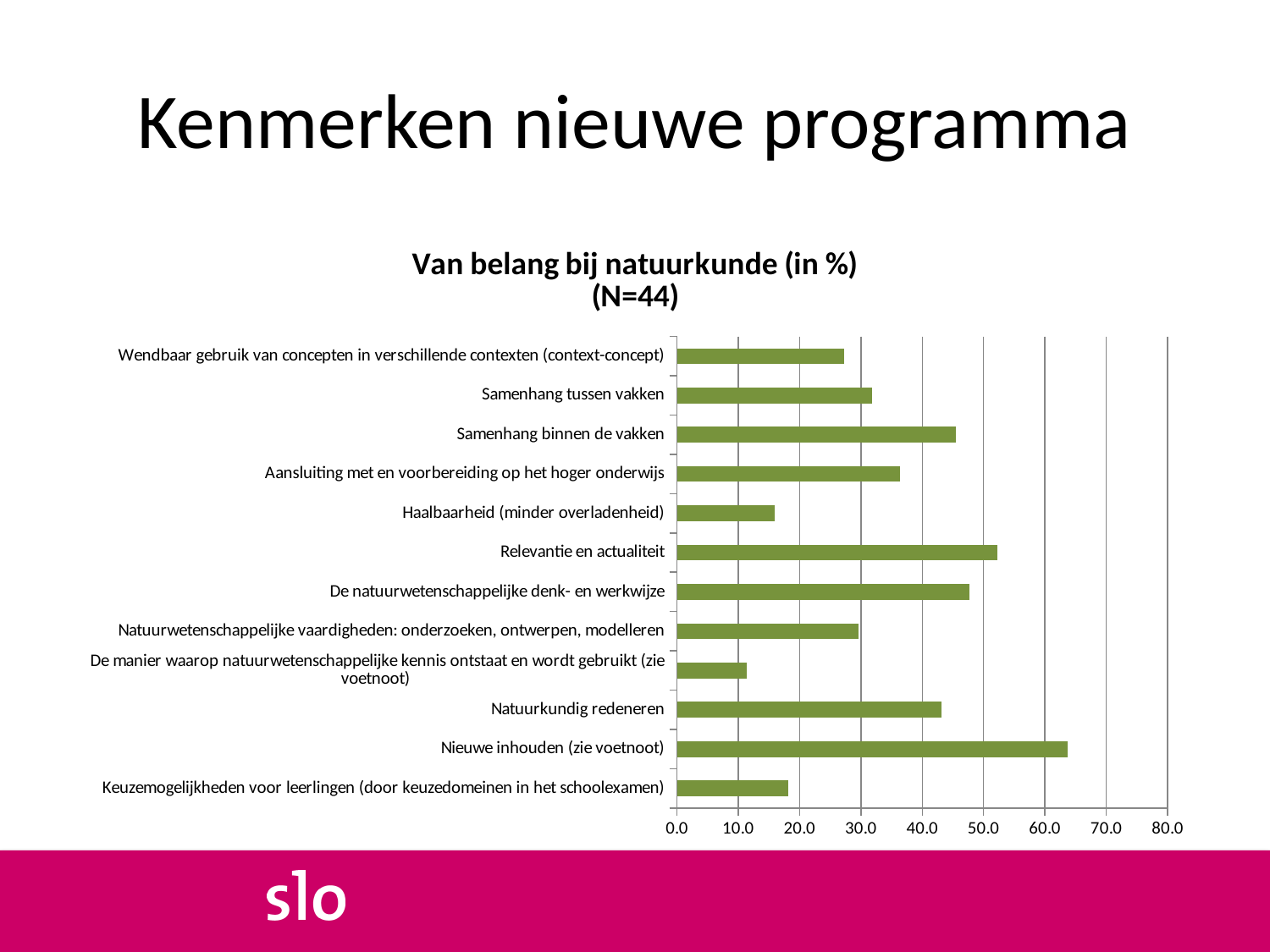
What is the maximum value shown on the horizontal axis? 80.0 Which category has the highest value? Nieuwe inhouden (zie voetnoot) Is the value for Relevantie en actualiteit greater or less than 50.0? greater Which category has the lowest value? De manier waarop natuurwetenschappelijke kennis ontstaat en wordt gebruikt (zie voetnoot) How many categories are plotted in the chart? 12 Is the value for Samenhang tussen vakken greater or less than 40.0? less What type of chart is shown on the slide? bar chart Which is larger: the value for Relevantie en actualiteit or the value for Samenhang binnen de vakken? Relevantie en actualiteit Is the value for Haalbaarheid (minder overladenheid) greater or less than 20.0? less Which is larger: the value for Natuurkundig redeneren or the value for Keuzemogelijkheden voor leerlingen (door keuzedomeinen in het schoolexamen)? Natuurkundig redeneren What is the title of the chart? Van belang bij natuurkunde (in %) (N=44)